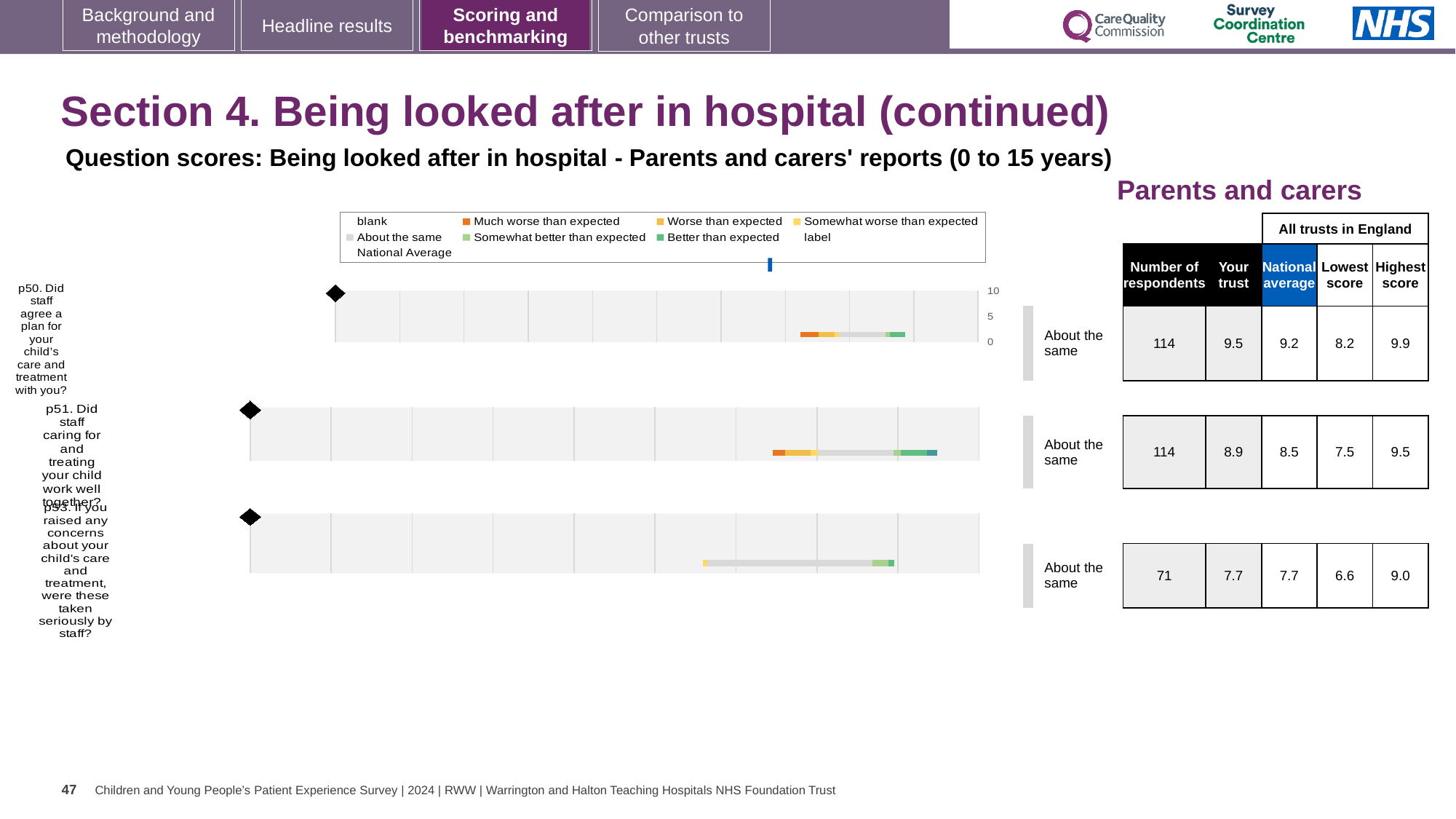
What benchmark category label is shown beside each of the three charts? About the same What kind of chart is used to show the p50 question scores? bar chart How many question charts are shown on the slide? 3 Which question has the highest 'Your trust' score in the tables? p50 For p51, which is larger: the 'Your trust' score or the national average? Your trust For p50, what is the difference between the highest score and the lowest score in the table? 1.7 In the table beside the p50 chart, what is the 'Your trust' score? 9.5 In the table beside the p53 chart, how many respondents are listed? 71 In the table beside the p53 chart, what is the lowest score among all trusts in England? 6.6 Which question has the lowest number of respondents in the tables? p53 In the table beside the p51 chart, what is the national average score? 8.5 What is the highest tick value shown on the axis of the p50 chart? 10